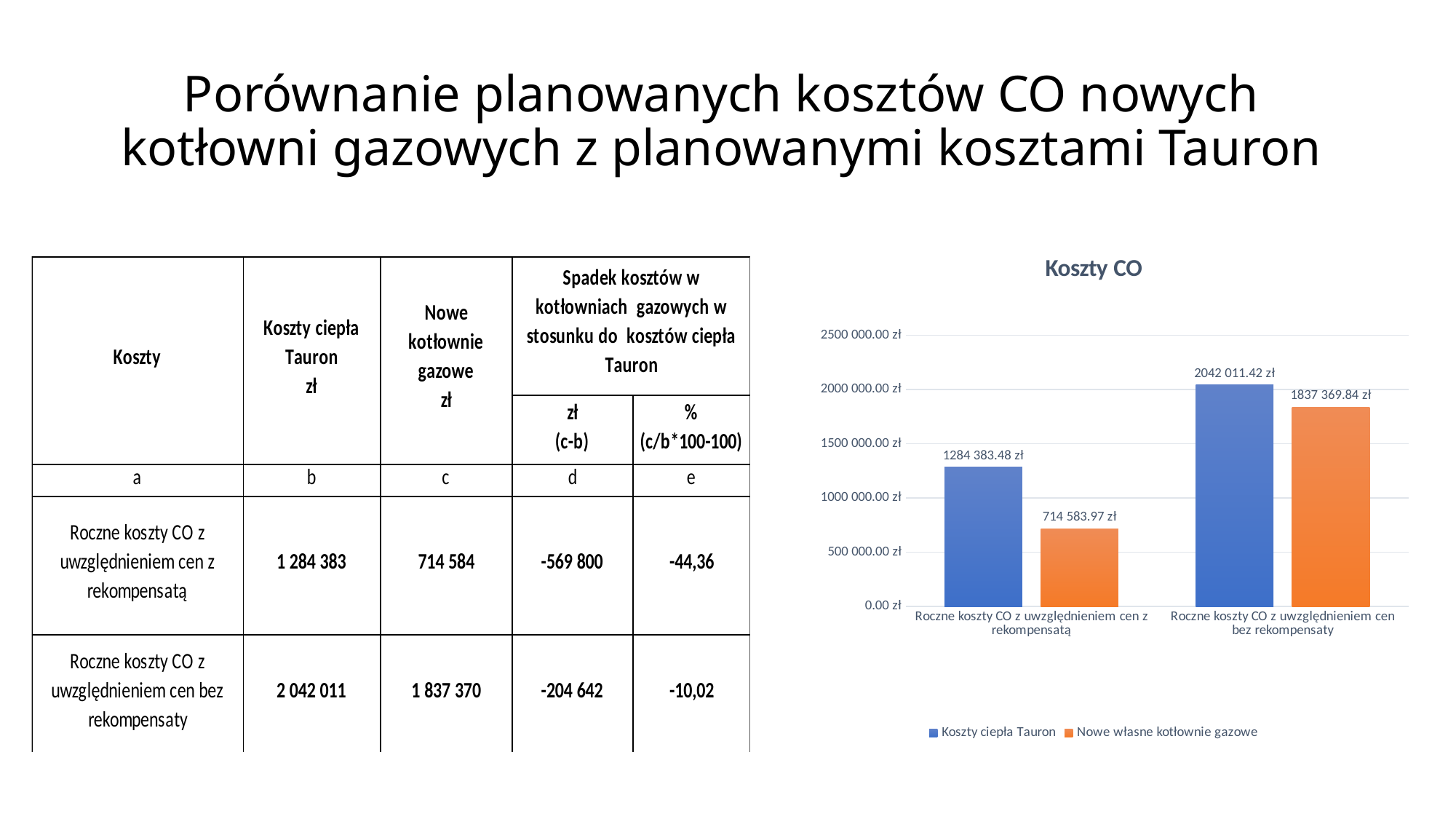
What is the value of Nowe własne kotłownie gazowe for 'Roczne koszty CO z uwzględnieniem cen bez rekompensaty' in the Koszty CO chart? 1837 369.84 zł In the Koszty CO chart, what is the difference between Koszty ciepła Tauron and Nowe własne kotłownie gazowe for 'Roczne koszty CO z uwzględnieniem cen bez rekompensaty'? 204 641.58 zł What is the value of Koszty ciepła Tauron for 'Roczne koszty CO z uwzględnieniem cen bez rekompensaty' in the Koszty CO chart? 2042 011.42 zł Which bar in the Koszty CO chart has the lowest value? Nowe własne kotłownie gazowe, Roczne koszty CO z uwzględnieniem cen z rekompensatą Which bar in the Koszty CO chart has the highest value? Koszty ciepła Tauron, Roczne koszty CO z uwzględnieniem cen bez rekompensaty What is the value of Koszty ciepła Tauron for 'Roczne koszty CO z uwzględnieniem cen z rekompensatą' in the Koszty CO chart? 1284 383.48 zł What is the value of Nowe własne kotłownie gazowe for 'Roczne koszty CO z uwzględnieniem cen z rekompensatą' in the Koszty CO chart? 714 583.97 zł How many categories are shown on the x axis of the Koszty CO chart? 2 In the Koszty CO chart, which is larger for 'Roczne koszty CO z uwzględnieniem cen bez rekompensaty': Koszty ciepła Tauron or Nowe własne kotłownie gazowe? Koszty ciepła Tauron How many series does the legend of the Koszty CO chart list? 2 In the Koszty CO chart, what is the difference between Koszty ciepła Tauron and Nowe własne kotłownie gazowe for 'Roczne koszty CO z uwzględnieniem cen z rekompensatą'? 569 799.51 zł What type of chart is the Koszty CO chart? Bar chart